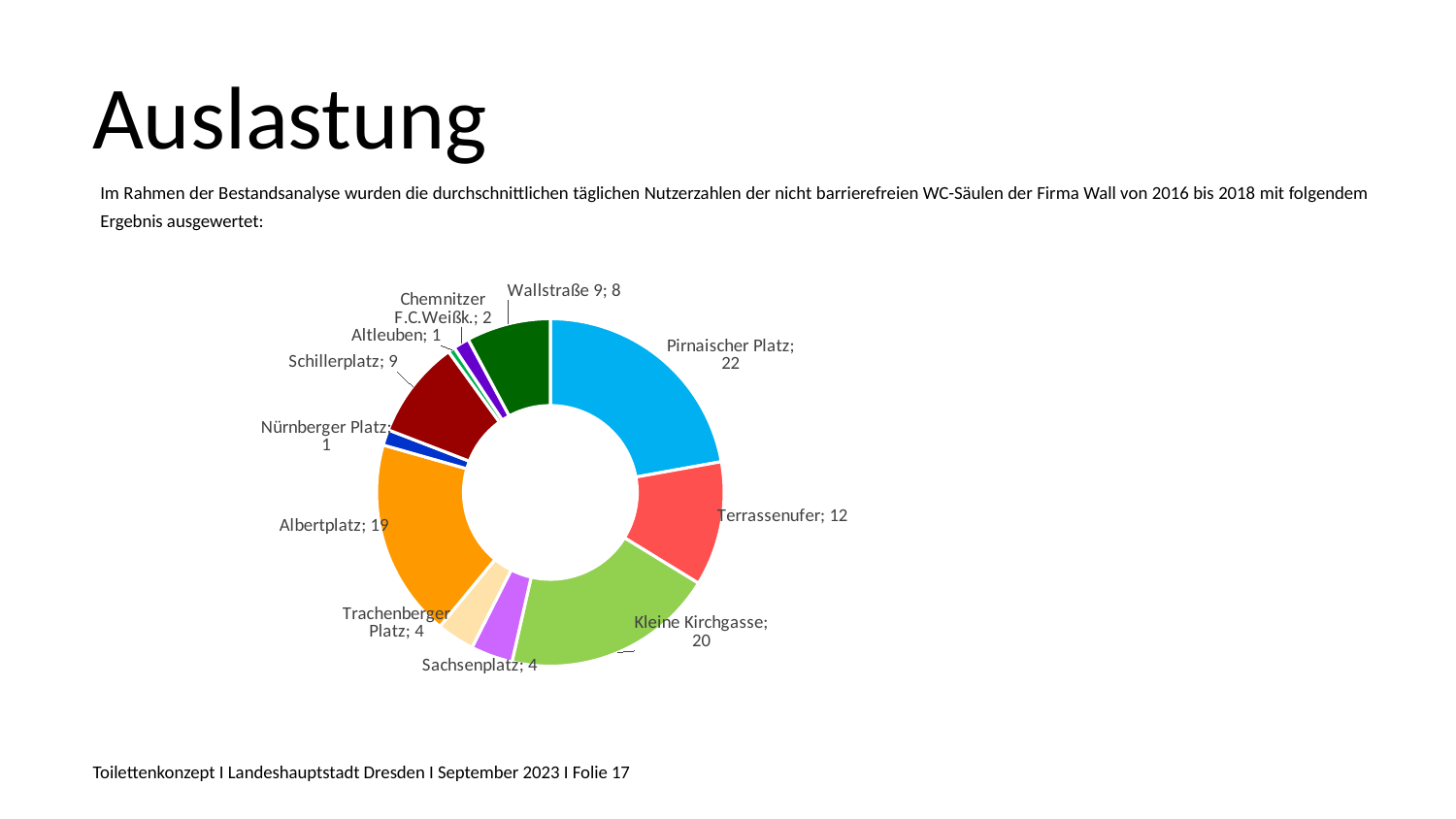
Which has a larger value, Schillerplatz or Trachenberger Platz? Schillerplatz What is the value for Albertplatz? 19 Which has a larger value, Kleine Kirchgasse or Albertplatz? Kleine Kirchgasse Which category has the highest value? Pirnaischer Platz What is the difference between the values for Pirnaischer Platz and Terrassenufer? 10 What is the value for Pirnaischer Platz? 22 What is the value for Terrassenufer? 12 What kind of chart is shown on the slide? doughnut chart How many categories are shown in the chart? 11 What is the value for Schillerplatz? 9 What is the value for Wallstraße 9? 8 What is the difference between the values for Kleine Kirchgasse and Wallstraße 9? 12